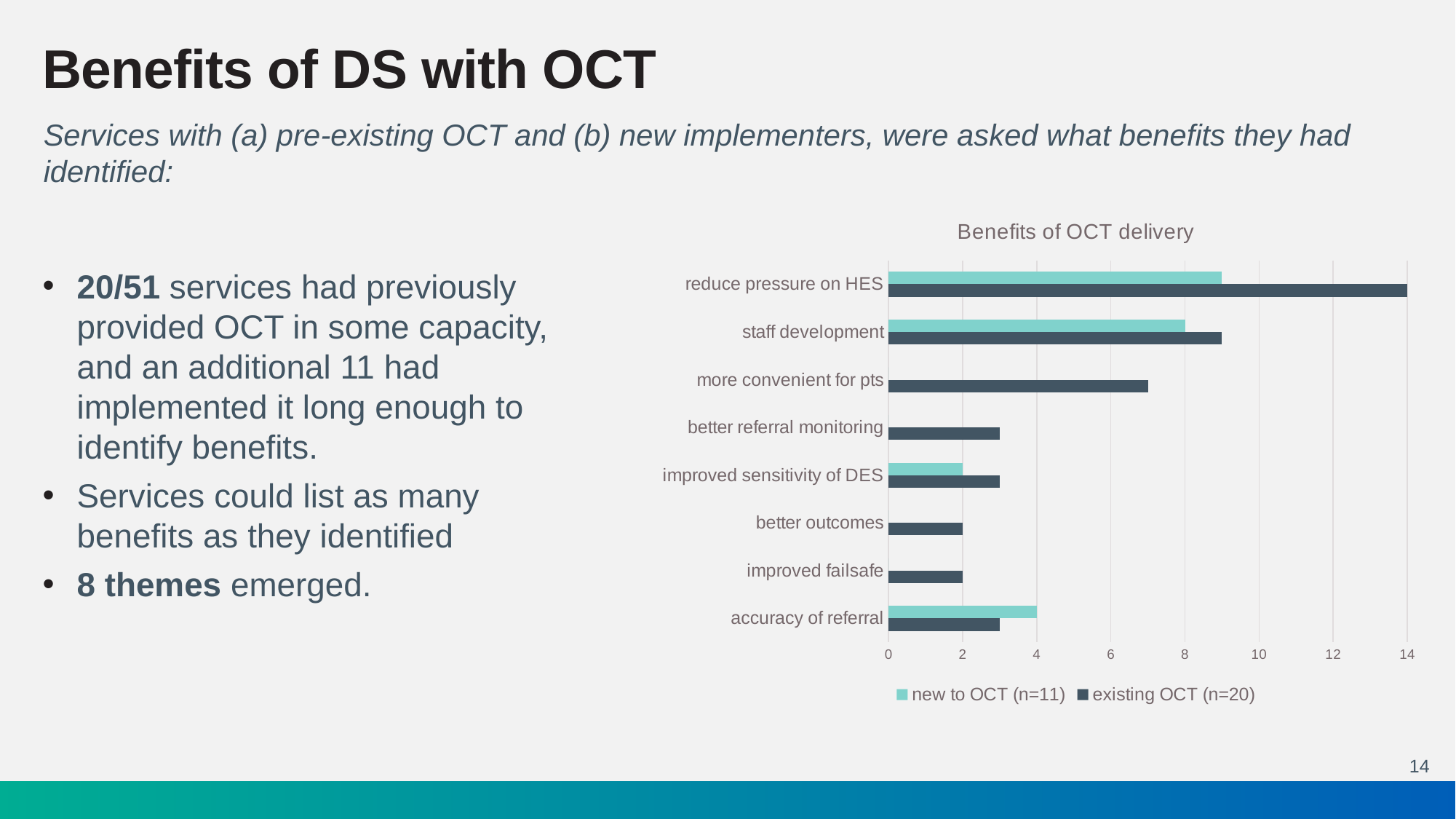
Which category has the highest value in the existing OCT (n=20) series? reduce pressure on HES How many series does the chart legend list? 2 What is the title of the chart? Benefits of OCT delivery What is the value for 'accuracy of referral' in the new to OCT (n=11) series? 4 What kind of chart is shown on the slide? bar chart What is the value for 'reduce pressure on HES' in the existing OCT (n=20) series? 14 What is the value for 'staff development' in the new to OCT (n=11) series? 8 Is the value for 'more convenient for pts' in the existing OCT (n=20) series greater or less than 6? greater What is the value for 'better outcomes' in the existing OCT (n=20) series? 2 How many benefit categories are shown on the chart? 8 Is the value for 'reduce pressure on HES' in the new to OCT (n=11) series greater or less than 8? greater For 'accuracy of referral', which series has the larger value: new to OCT (n=11) or existing OCT (n=20)? new to OCT (n=11)